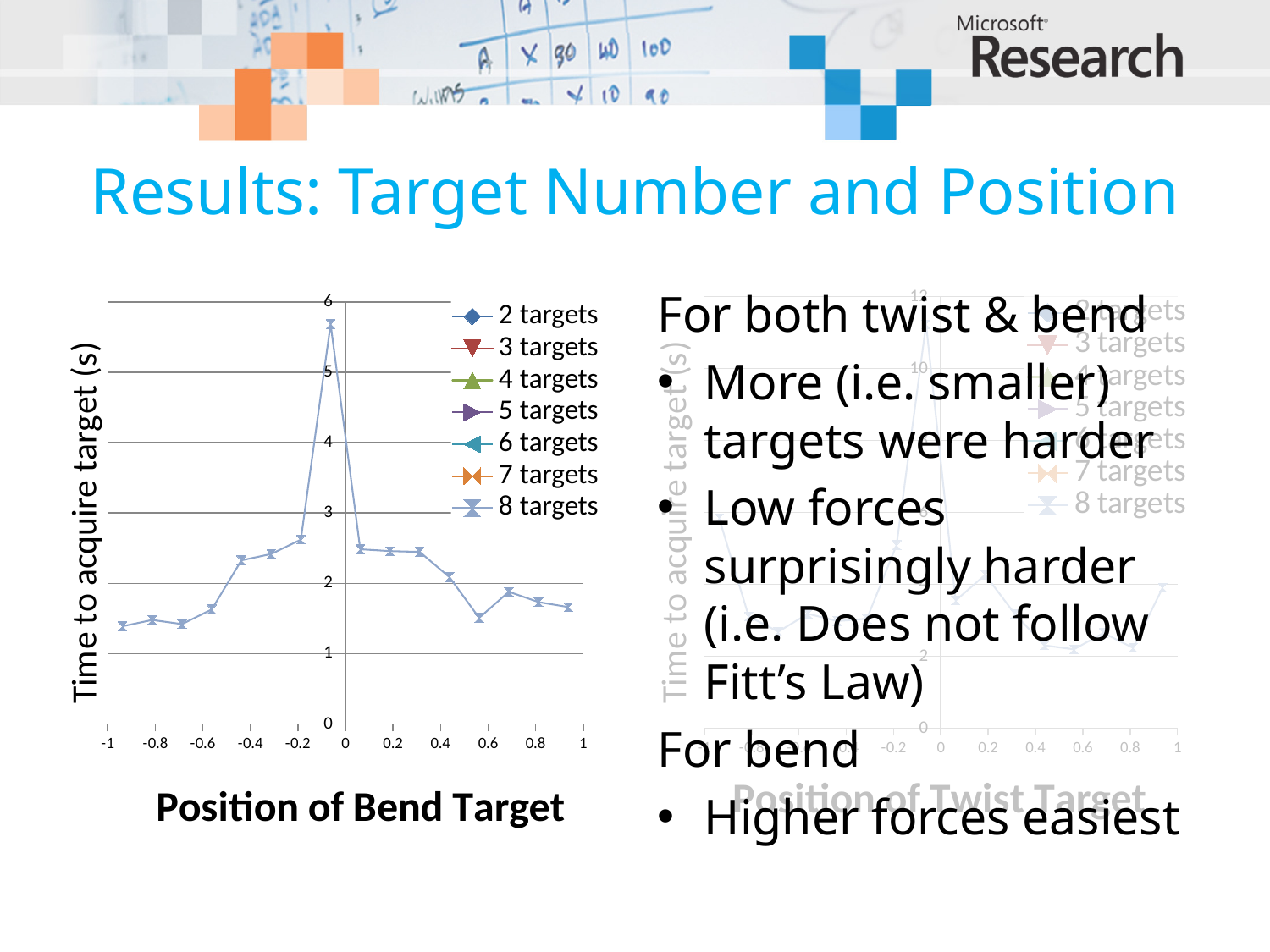
On the Position of Bend Target chart, is the value at about x = -0.4 greater or less than 2? greater On the Position of Bend Target chart, what is the label of the y axis? Time to acquire target (s) On the Position of Bend Target chart, how many series does the legend list? 7 On the Position of Bend Target chart, is the value at the rightmost point (near x = 1) greater or less than 2? less On the Position of Bend Target chart, what is the first entry in the legend? 2 targets On the Position of Bend Target chart, what kind of chart is shown? line chart On the Position of Bend Target chart, is the peak value of the plotted line greater or less than 5? greater On the Position of Bend Target chart, do the values rise or fall as the x position goes from -1 toward the peak just left of 0? rise On the Position of Bend Target chart, do the values generally rise or fall as the x position goes from the peak toward 1? fall On the Position of Bend Target chart, is the highest point of the line located to the left or to the right of x = 0? left